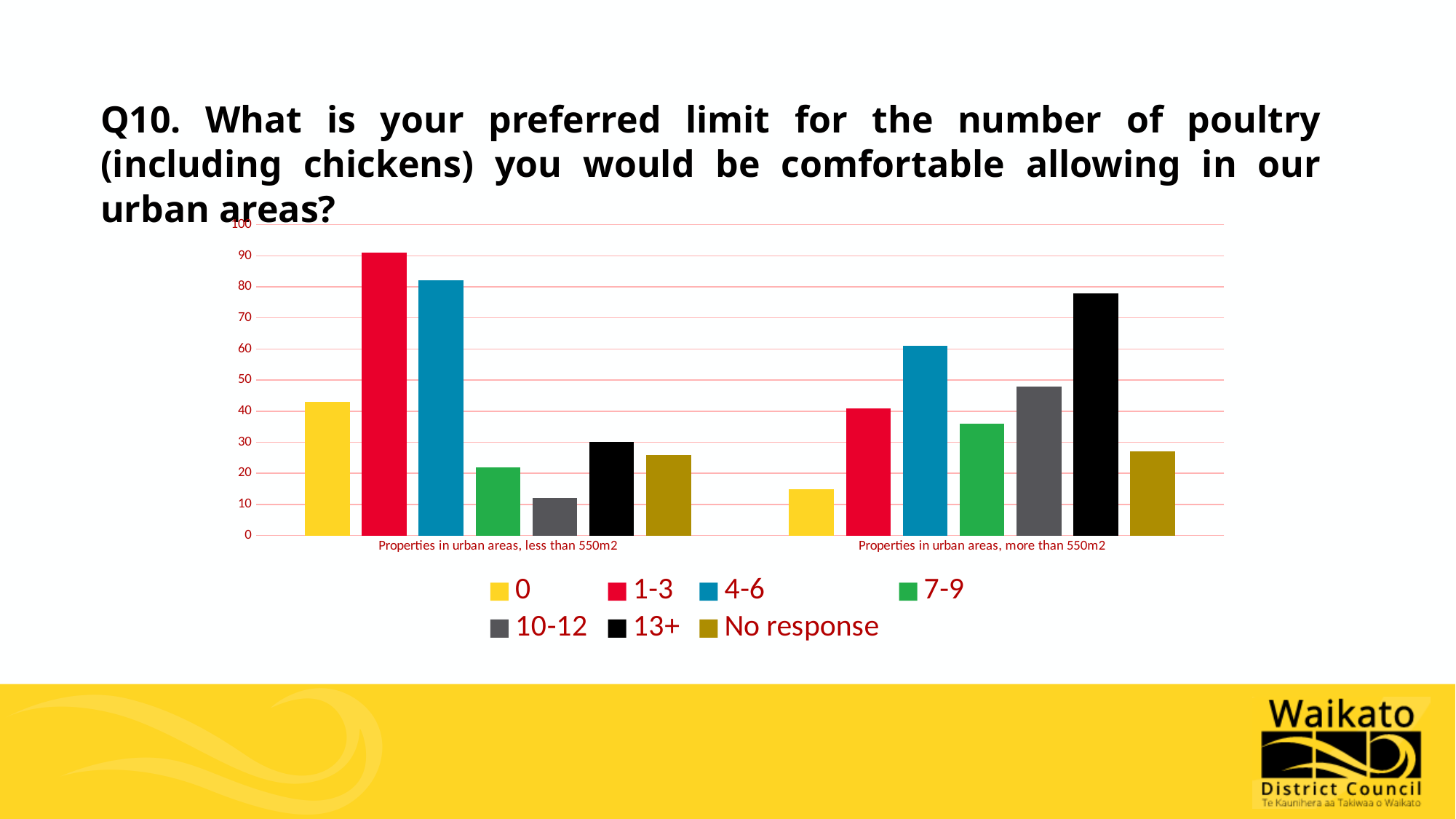
For properties in urban areas more than 550m2, which response option has the highest bar? 13+ For properties in urban areas more than 550m2, which response option has the lowest bar? 0 Is the value for 4-6 in properties in urban areas more than 550m2 greater or less than 50? greater Is the value for 10-12 in properties in urban areas less than 550m2 greater or less than 20? less How many property categories are shown on the x axis? 2 What colour represents the 13+ series in the legend? black For properties in urban areas less than 550m2, which response option has the lowest bar? 10-12 How many series does the legend list? 7 For properties in urban areas less than 550m2, which response option has the highest bar? 1-3 What kind of chart is shown on the slide? bar chart Is the value for 1-3 in properties in urban areas less than 550m2 greater or less than 80? greater Which category has the larger value for the 0 series: properties less than 550m2 or properties more than 550m2? Properties in urban areas, less than 550m2